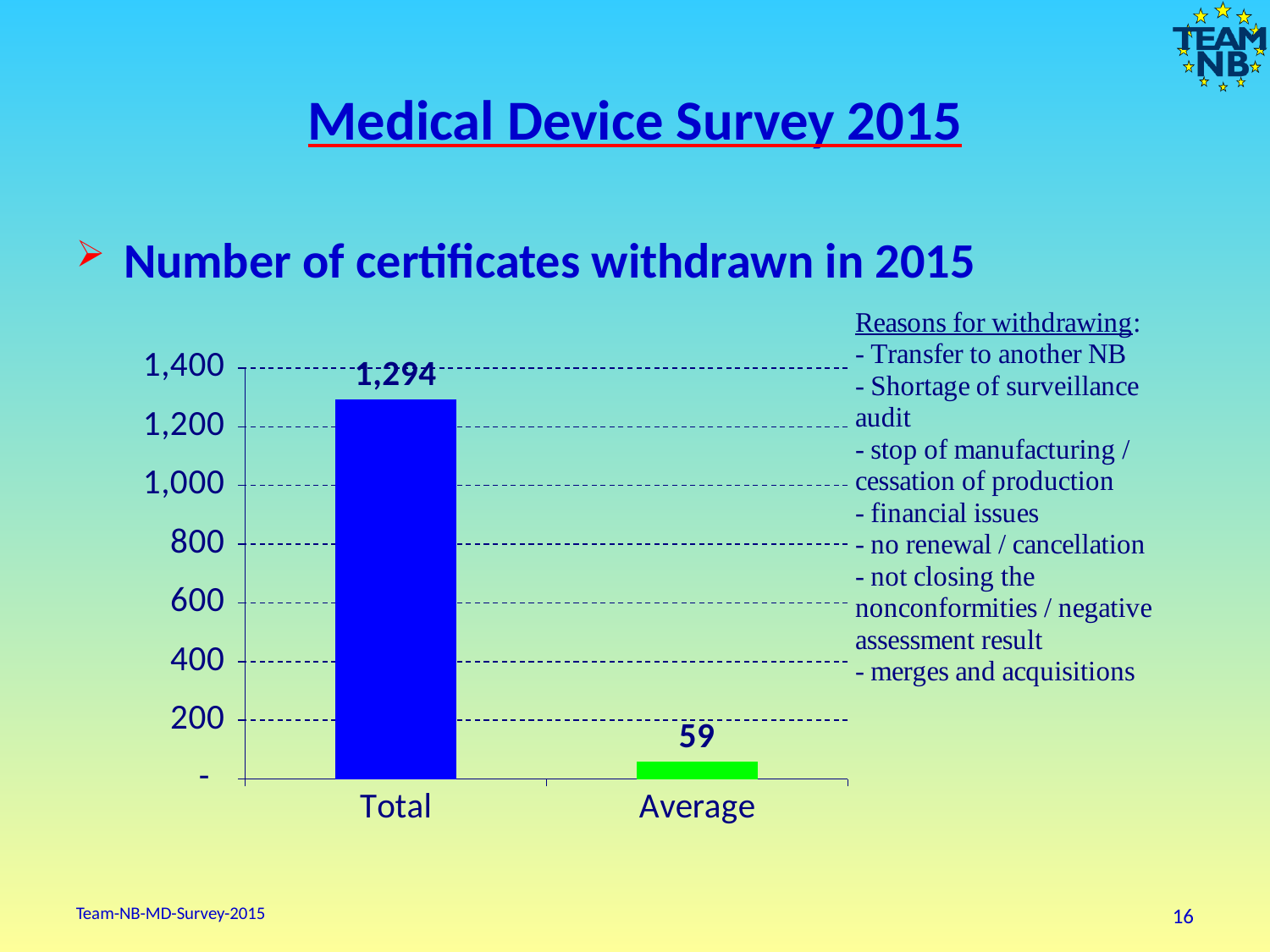
Which is larger, the Total bar or the Average bar? Total Is the value for Average greater or less than 200? less What is the difference between the Total and Average values? 1,235 Which category has the highest value? Total What is the highest value shown on the y axis? 1,400 Which category has the lowest value? Average What colour is the Average bar? green How many categories are shown on the x axis? 2 What is the value of the Total bar? 1,294 Is the value for Total greater or less than 1,200? greater What is the value of the Average bar? 59 What kind of chart is shown on the slide? bar chart